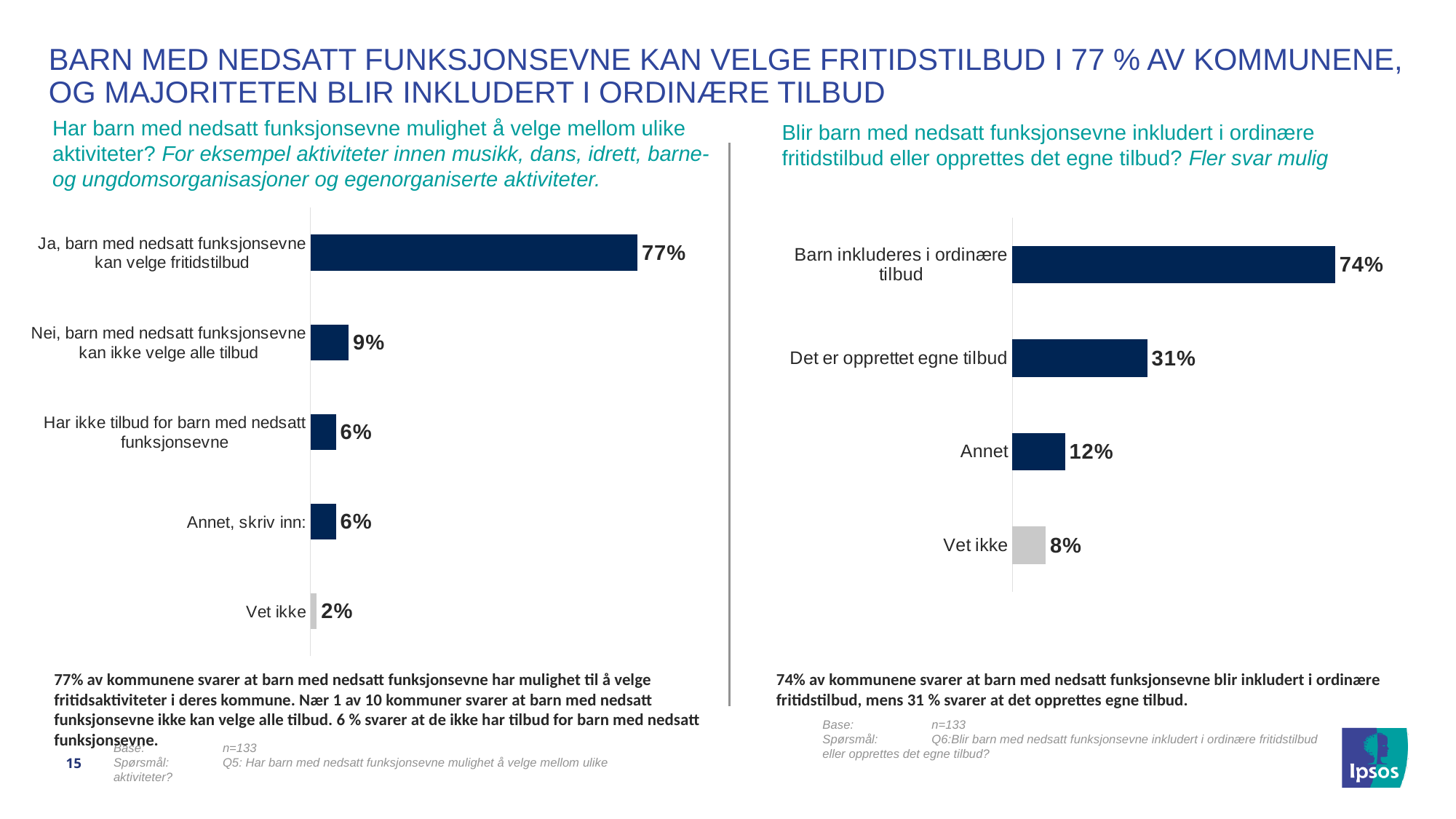
In the right chart, how many categories are shown? 4 In the right chart, which is larger: 'Annet' or 'Vet ikke'? Annet In the right chart, which category has the highest value? Barn inkluderes i ordinære tilbud In the left chart, what is the value for 'Nei, barn med nedsatt funksjonsevne kan ikke velge alle tilbud'? 9% In the left chart, how many categories are shown? 5 In the left chart, what is the value for 'Vet ikke'? 2% In the left chart, which category has the lowest value? Vet ikke In the left chart, what percentage of municipalities answered 'Ja, barn med nedsatt funksjonsevne kan velge fritidstilbud'? 77% In the right chart, what is the value for 'Annet'? 12% What type of chart is the right chart? Bar chart In the left chart, what is the difference between 'Ja, barn med nedsatt funksjonsevne kan velge fritidstilbud' and 'Nei, barn med nedsatt funksjonsevne kan ikke velge alle tilbud'? 68 percentage points In the right chart, what is the value for 'Det er opprettet egne tilbud'? 31%